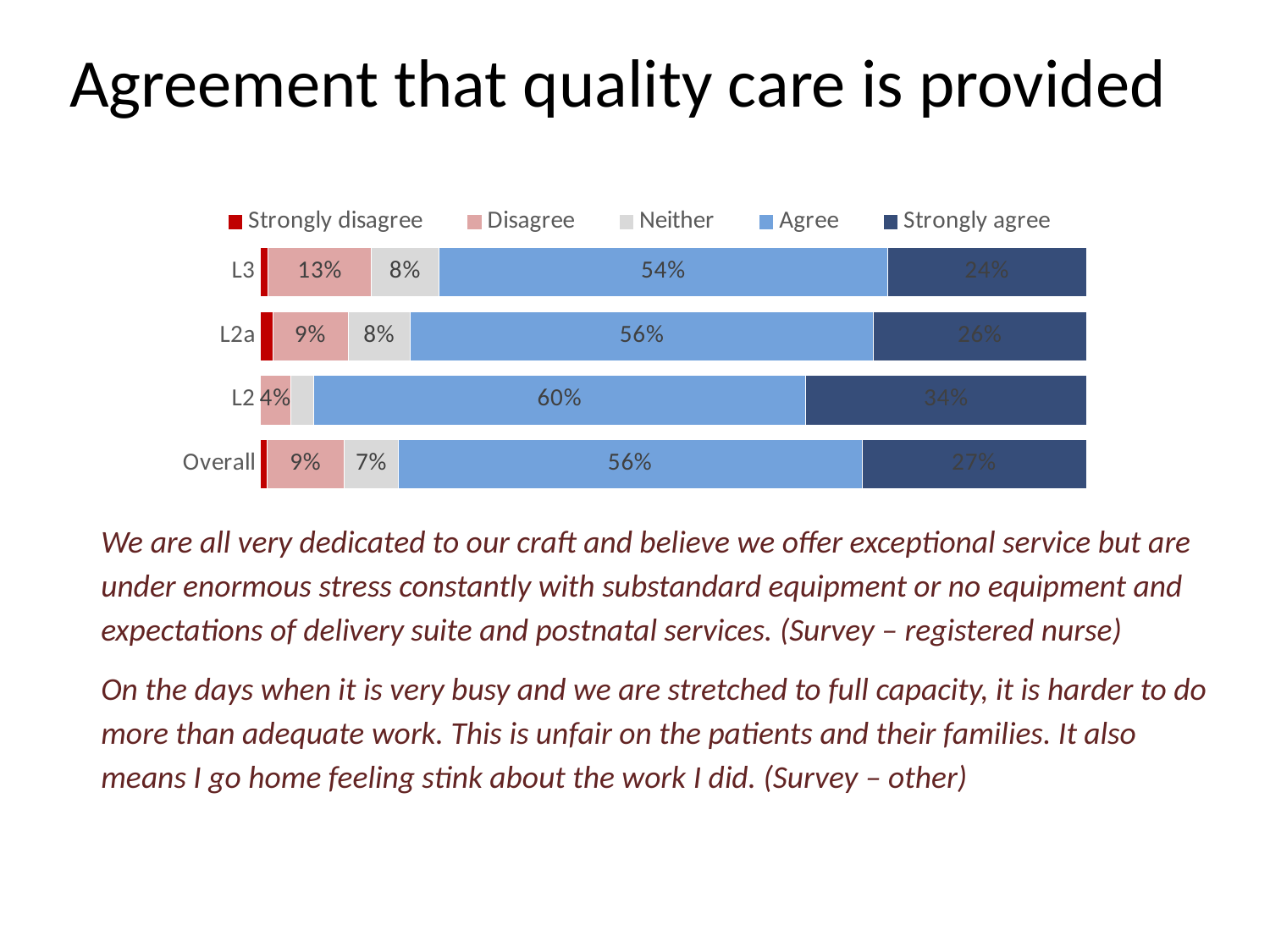
Which group has the highest Disagree percentage? L3 What is the Neither value for L2a? 8% What kind of chart is shown on the slide? Stacked bar chart Which group has the lowest Strongly agree percentage? L3 What is the Disagree value for the Overall group? 9% What percentage of L3 respondents agree that quality care is provided? 54% How many groups are shown on the chart? 4 What is the Strongly agree value for L2? 34% Which group has the highest Agree percentage? L2 Which is larger: the Strongly agree value for L2a or for Overall? Overall How many series does the legend list? 5 What is the difference between the Disagree percentage for L3 and for L2a? 4 percentage points